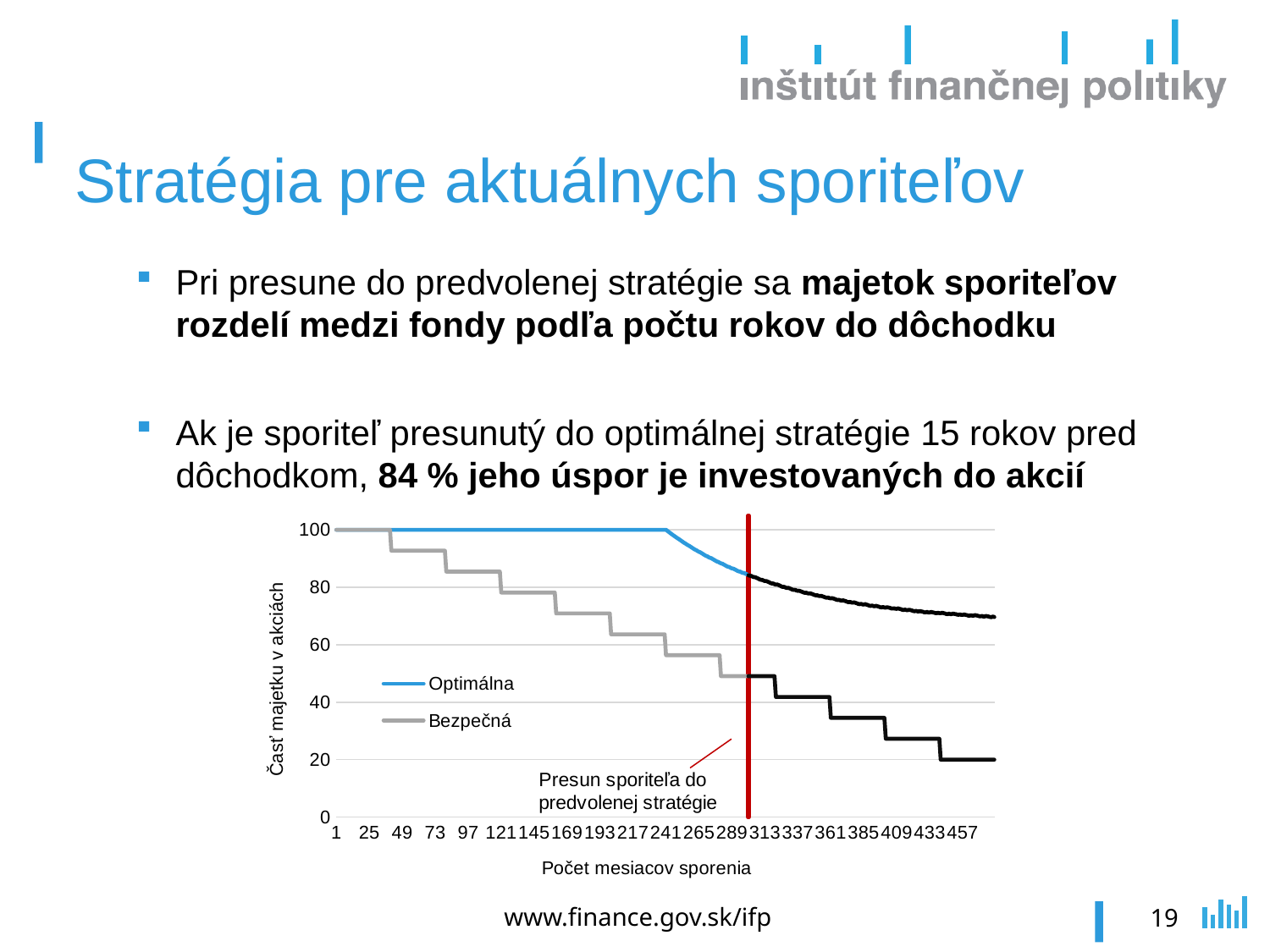
Does the Bezpečná series rise or fall as the number of months of saving increases? fall At month 457, which series has the higher value, Optimálna or Bezpečná? Optimálna Is the value of the Optimálna series at month 241 greater or less than 80? greater Is the value of the Bezpečná series at month 121 greater or less than 60? greater What kind of chart is shown on the slide? line chart What are the two series named in the chart legend? Optimálna and Bezpečná What is the value of the Optimálna series at month 1? 100 What is the value of the Bezpečná series at month 457? 20 Is the value of the Bezpečná series at month 457 greater or less than 40? less What does the red vertical line in the chart mark, according to its label? Presun sporiteľa do predvolenej stratégie How many series does the chart legend list? 2